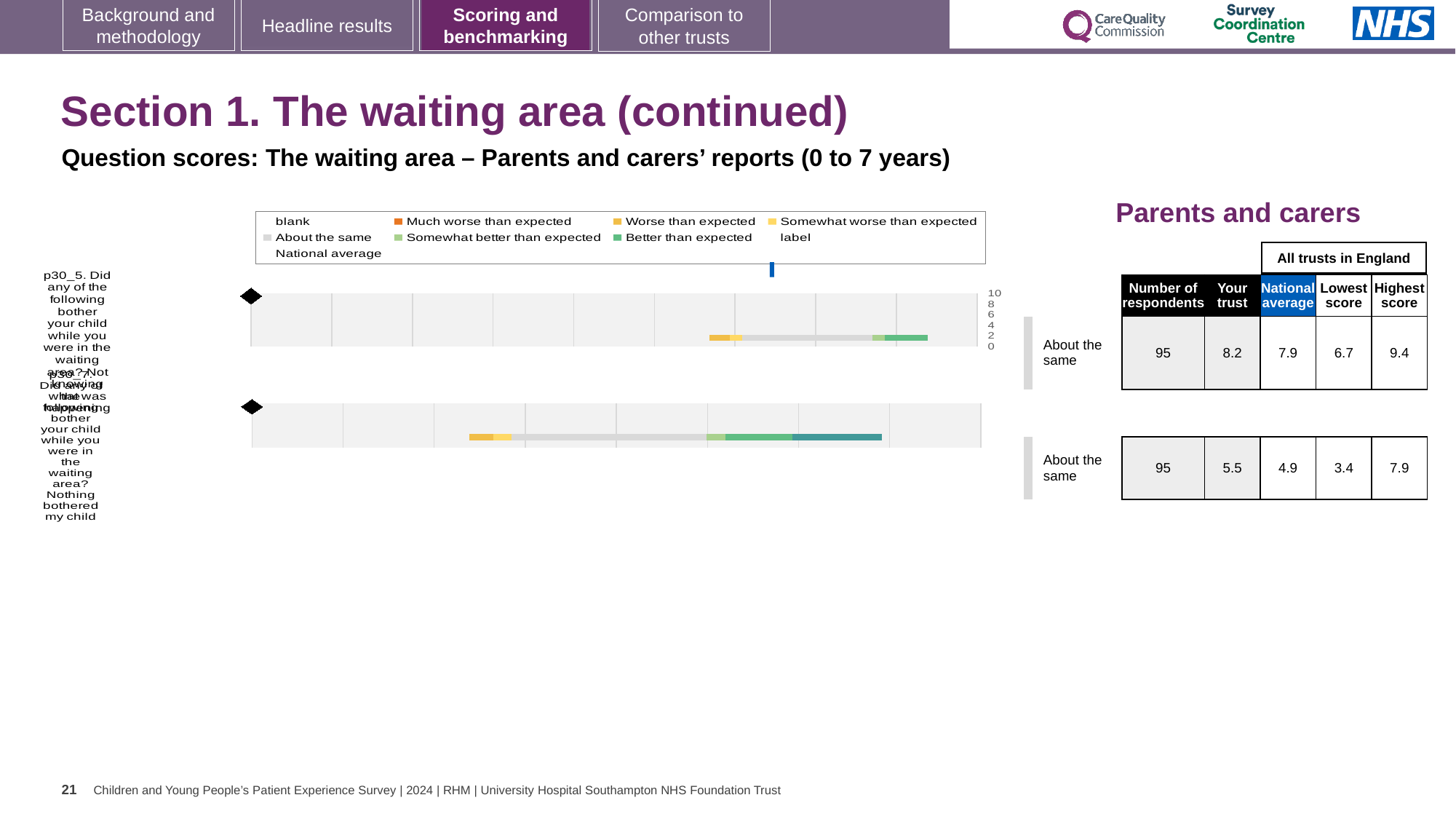
What is the highest value shown on the chart's numeric axis? 10 How many question bars are plotted in the chart? 2 Which legend entry is shown in dark green? Better than expected What is the lowest score across all trusts in England for question p30_7? 3.4 For question p30_5, what is the difference between the highest score (9.4) and the lowest score (6.7) across all trusts in England? 2.7 For question p30_7, what is the difference between the 'Your trust' score and the national average? 0.6 In the table for question p30_7 (Nothing bothered my child), what is the national average score? 4.9 What kind of chart is shown on the slide? bar chart Which of the two questions has the higher 'Your trust' score, p30_5 or p30_7? p30_5 For question p30_5, is the 'Your trust' score or the national average larger? Your trust In the table for question p30_5 (Did any of the following bother your child while you were in the waiting area? Not knowing what was happening), what is the 'Your trust' score? 8.2 How many respondents are listed for question p30_5? 95